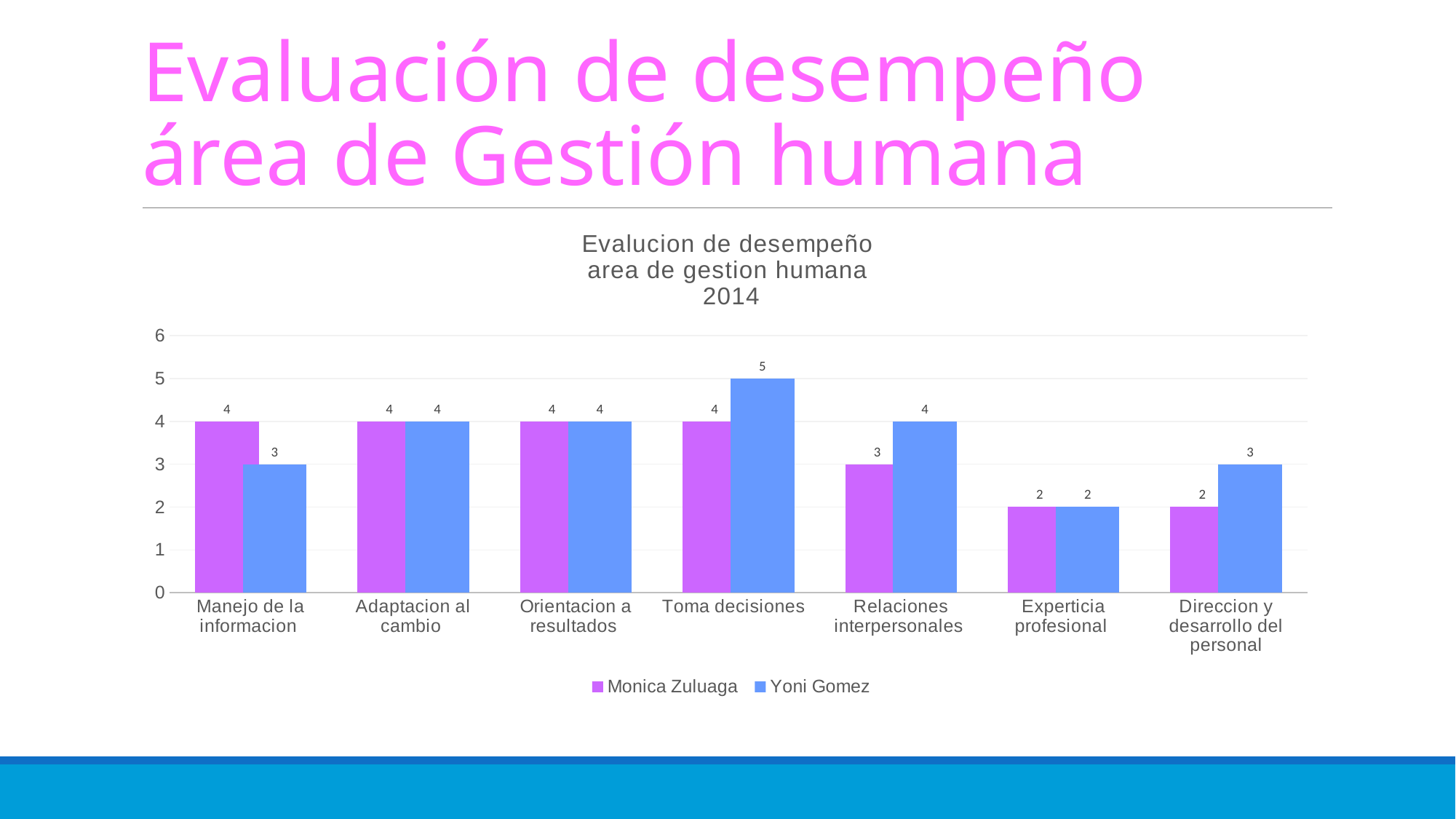
In the Direccion y desarrollo del personal category, who has the larger value, Monica Zuluaga or Yoni Gomez? Yoni Gomez What is the difference between Yoni Gomez and Monica Zuluaga in the Toma decisiones category? 1 What kind of chart is shown on the slide? Bar chart What is the difference between Monica Zuluaga and Yoni Gomez in the Manejo de la informacion category? 1 What is the value for Yoni Gomez in the Manejo de la informacion category? 3 What is the value for Monica Zuluaga in the Relaciones interpersonales category? 3 How many series does the chart legend list? 2 Which category has the highest value for Yoni Gomez? Toma decisiones What is the value for Yoni Gomez in the Toma decisiones category? 5 How many categories are shown on the x axis of the chart? 7 In the Manejo de la informacion category, who has the larger value, Monica Zuluaga or Yoni Gomez? Monica Zuluaga What is the title of the chart? Evalucion de desempeño area de gestion humana 2014